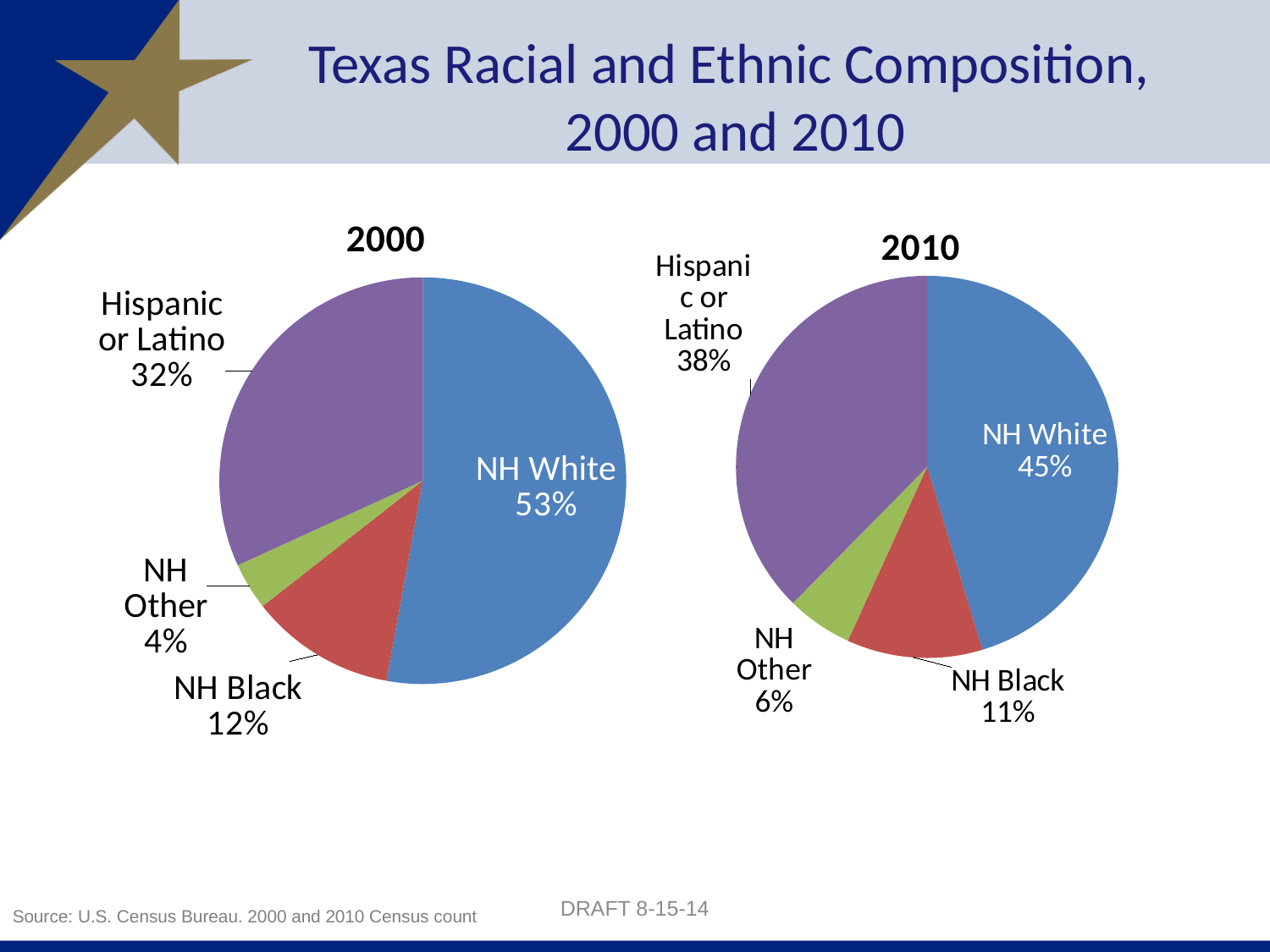
What is the title of the slide? Texas Racial and Ethnic Composition, 2000 and 2010 In the 2010 pie chart, what share is Hispanic or Latino? 38% In the 2010 pie chart, which group has the smallest share? NH Other In the 2010 pie chart, which is larger: the NH Black share or the NH Other share? NH Black In the 2010 pie chart, what share is NH Other? 6% How many slices does the 2000 pie chart have? 4 What is the difference between the NH White share in 2000 and in 2010? 8 percentage points Did the Hispanic or Latino share rise or fall from 2000 to 2010? Rise In the 2000 pie chart, what share is NH White? 53% In the 2000 pie chart, which group has the largest share? NH White What kind of charts are shown on the slide? Pie charts In the 2000 pie chart, what share is NH Black? 12%